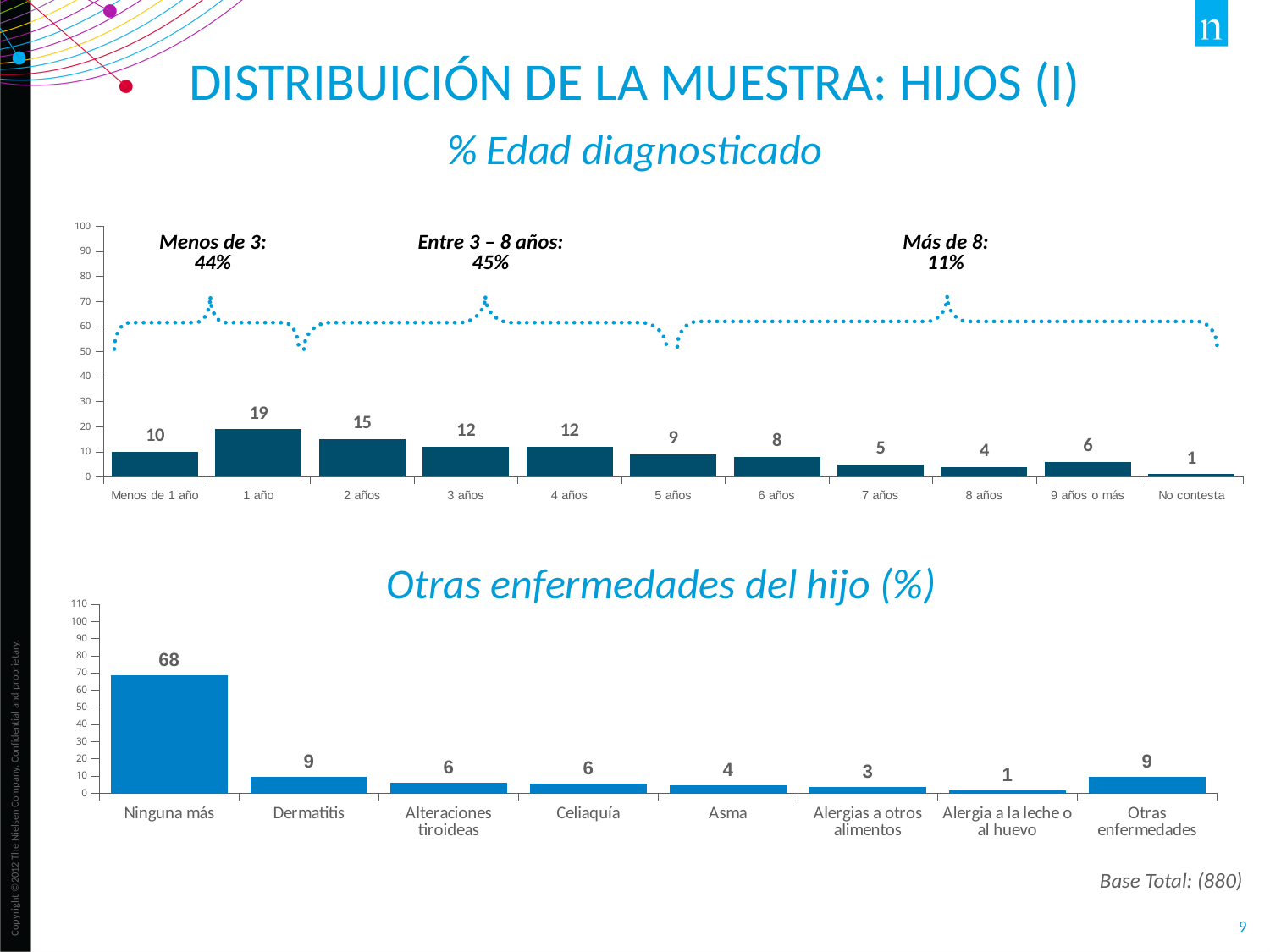
In the 'Otras enfermedades del hijo (%)' chart, how many categories are shown? 8 In the 'Otras enfermedades del hijo (%)' chart, which category has the lowest value? Alergia a la leche o al huevo In the '% Edad diagnosticado' chart, which category has the lowest value? No contesta In the '% Edad diagnosticado' chart, what is the difference between the values for '2 años' and '5 años'? 6 In the 'Otras enfermedades del hijo (%)' chart, what is the value for 'Ninguna más'? 68 In the '% Edad diagnosticado' chart, how many categories are shown on the x axis? 11 In the 'Otras enfermedades del hijo (%)' chart, which is larger: 'Dermatitis' or 'Asma'? Dermatitis In the '% Edad diagnosticado' chart, which category has the highest value? 1 año In the '% Edad diagnosticado' chart, what is the value for '1 año'? 19 What type of chart is the 'Otras enfermedades del hijo (%)' chart? Bar chart In the '% Edad diagnosticado' chart, what percentage is shown for the 'Entre 3 – 8 años' group? 45% In the 'Otras enfermedades del hijo (%)' chart, what is the difference between 'Ninguna más' and 'Dermatitis'? 59